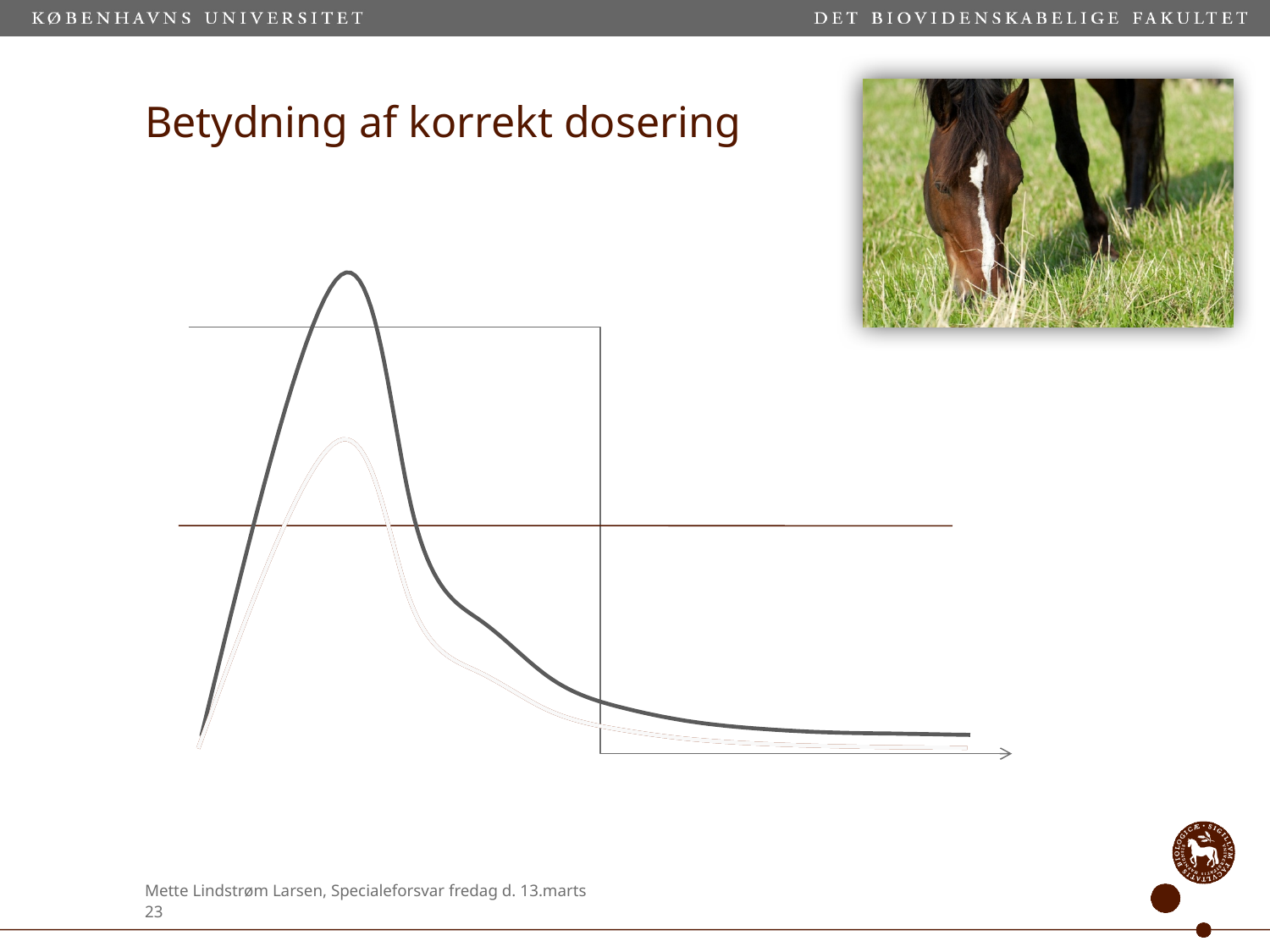
Does the peak of the light pink curve lie above or below the upper horizontal grey line? below Does the chart include a legend? No Does the dark grey curve rise or fall after its peak as it moves to the right along the x axis? fall Does the light pink curve rise or fall from the left edge up to its peak? rise How many curves are plotted on the chart? 2 What is the title of the slide containing the chart? Betydning af korrekt dosering Does the peak of the light pink curve lie above or below the horizontal brown line? above Does the peak of the dark grey curve lie above or below the upper horizontal grey line? above What kind of chart is shown on the slide? line chart